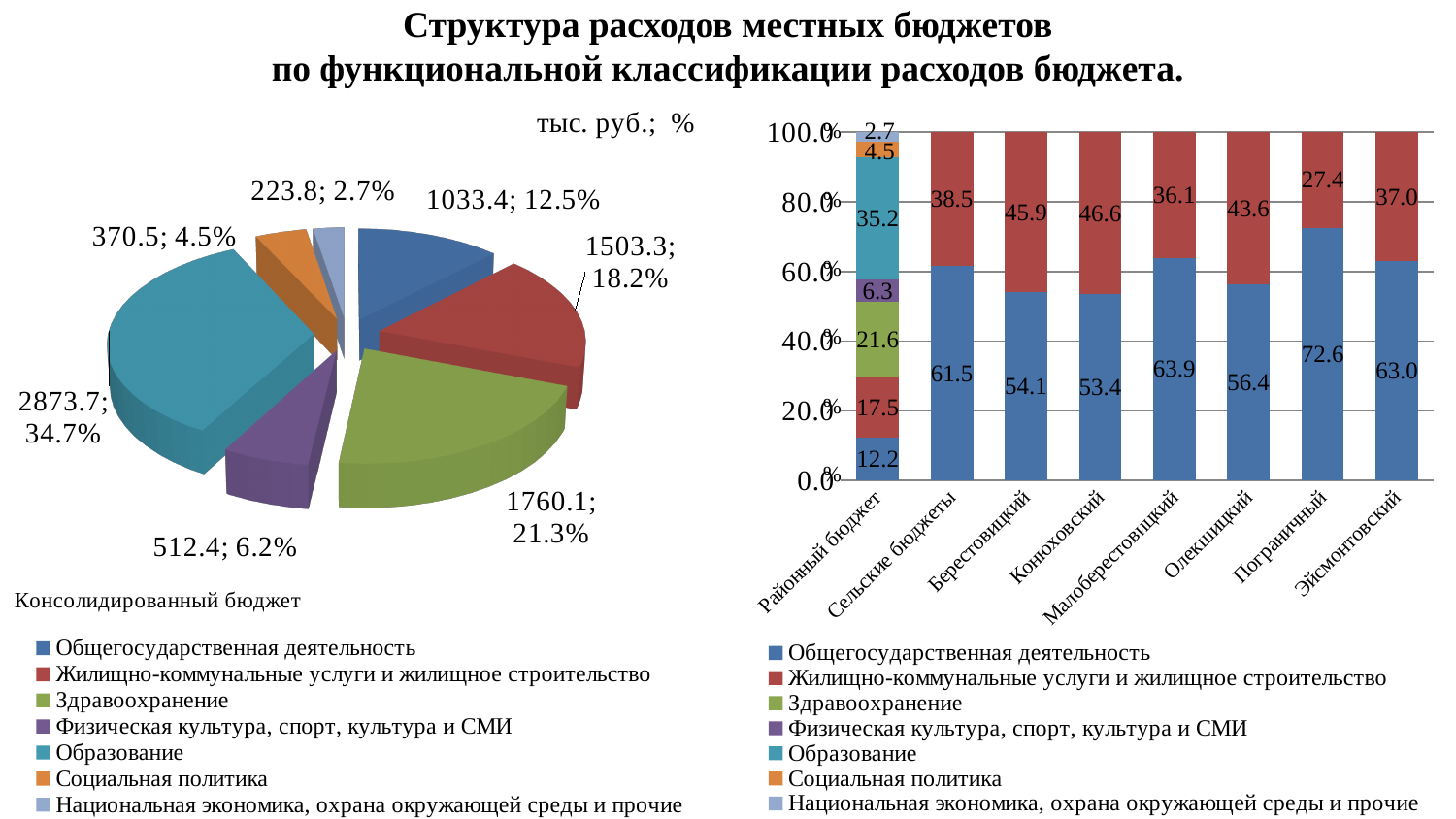
In the stacked bar chart on the right, what is the difference between the Общегосударственная деятельность values for Малоберестовицкий and Берестовицкий? 9.8 In the pie chart on the left, which category has the smallest slice? Национальная экономика, охрана окружающей среды и прочие What type of chart is shown on the right side of the slide? Stacked bar chart In the pie chart on the left, which category has the largest slice? Образование In the stacked bar chart on the right, what is the value of Общегосударственная деятельность for Пограничный? 72.6 In the stacked bar chart on the right, what is the value of Образование for Районный бюджет? 35.2 In the pie chart on the left, what share of the pie does Здравоохранение have? 21.3% In the stacked bar chart on the right, which category has the highest value for Общегосударственная деятельность? Пограничный In the stacked bar chart on the right, how many categories are shown on the x axis? 8 In the pie chart on the left, how many slices are there? 7 In the stacked bar chart on the right, what is the value of Жилищно-коммунальные услуги и жилищное строительство for Конюховский? 46.6 In the pie chart on the left, what is the value shown for Образование? 2873.7; 34.7%